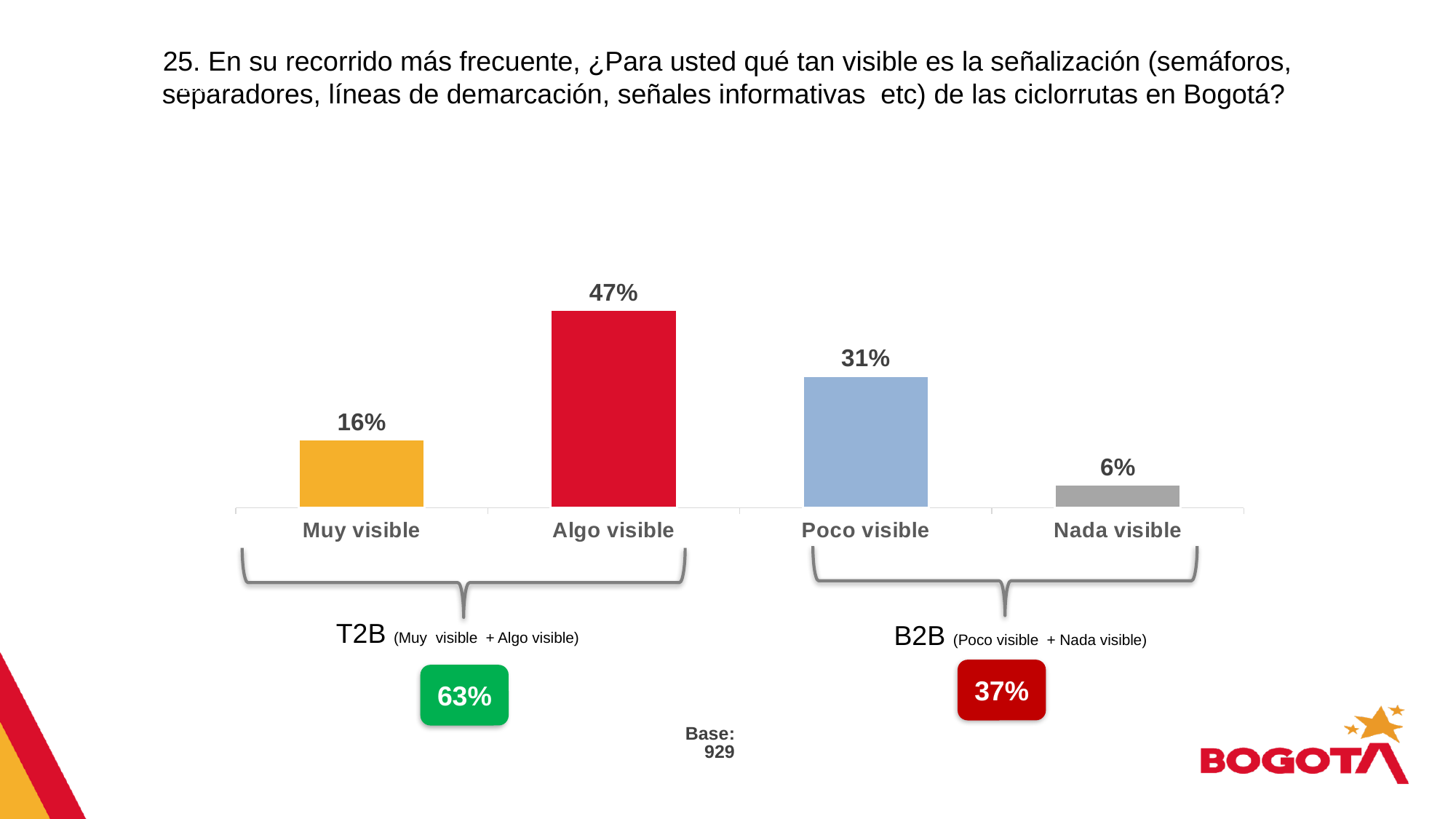
Which category has the lowest value? Nada visible What percentage of respondents answered "Algo visible"? 47% What base (number of respondents) is shown below the chart? 929 Which is larger, the value for "Poco visible" or the value for "Muy visible"? Poco visible What is the value shown for "Nada visible"? 6% What is the combined T2B value (Muy visible + Algo visible) shown on the slide? 63% What is the value shown for "Muy visible"? 16% What is the difference between the values for "Algo visible" and "Poco visible"? 16% Which category has the highest value? Algo visible What kind of chart is shown on the slide? Bar chart What is the combined B2B value (Poco visible + Nada visible) shown on the slide? 37% How many categories are shown on the x axis of the chart? 4